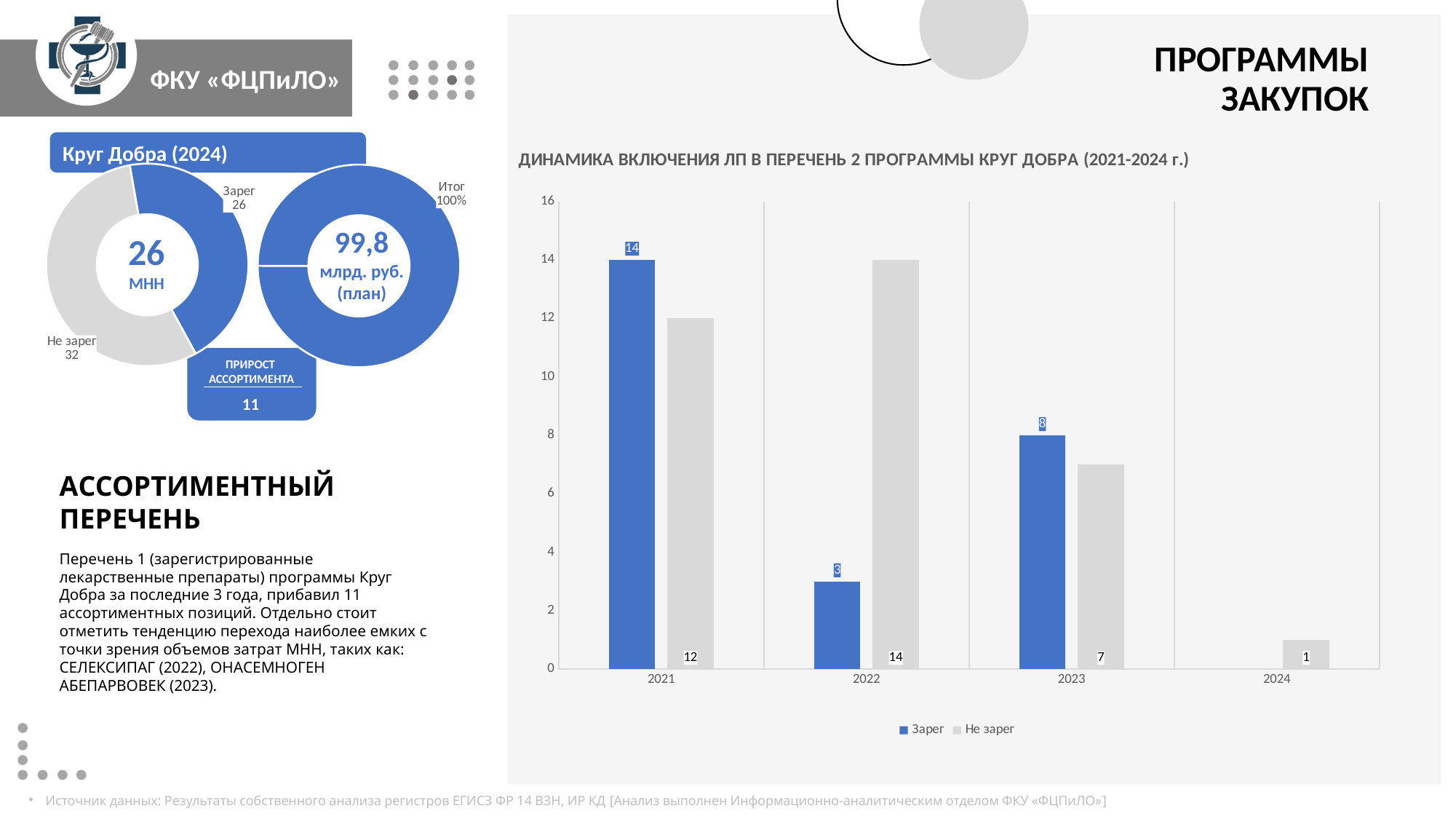
What type of chart is 'Динамика включения ЛП в перечень 2 программы Круг Добра (2021-2024 г.)'? Bar chart In the bar chart 'Динамика включения ЛП в перечень 2 программы Круг Добра (2021-2024 г.)', what is the value for Зарег in 2021? 14 In the bar chart 'Динамика включения ЛП в перечень 2 программы Круг Добра (2021-2024 г.)', which is larger in 2023: Зарег or Не зарег? Зарег In the bar chart 'Динамика включения ЛП в перечень 2 программы Круг Добра (2021-2024 г.)', what is the difference between Не зарег and Зарег in 2022? 11 In the bar chart 'Динамика включения ЛП в перечень 2 программы Круг Добра (2021-2024 г.)', how many years are shown on the x axis? 4 In the bar chart 'Динамика включения ЛП в перечень 2 программы Круг Добра (2021-2024 г.)', what is the value for Не зарег in 2022? 14 In the bar chart 'Динамика включения ЛП в перечень 2 программы Круг Добра (2021-2024 г.)', which year has the lowest value for Не зарег? 2024 In the donut chart 'Круг Добра (2024)' on the left, what is the value for Не зарег? 32 In the bar chart 'Динамика включения ЛП в перечень 2 программы Круг Добра (2021-2024 г.)', what is the value for Не зарег in 2024? 1 In the bar chart 'Динамика включения ЛП в перечень 2 программы Круг Добра (2021-2024 г.)', how many series does the legend list? 2 In the donut chart 'Круг Добра (2024)' on the left, what is the difference between Не зарег and Зарег? 6 In the bar chart 'Динамика включения ЛП в перечень 2 программы Круг Добра (2021-2024 г.)', which year has the highest value for Зарег? 2021